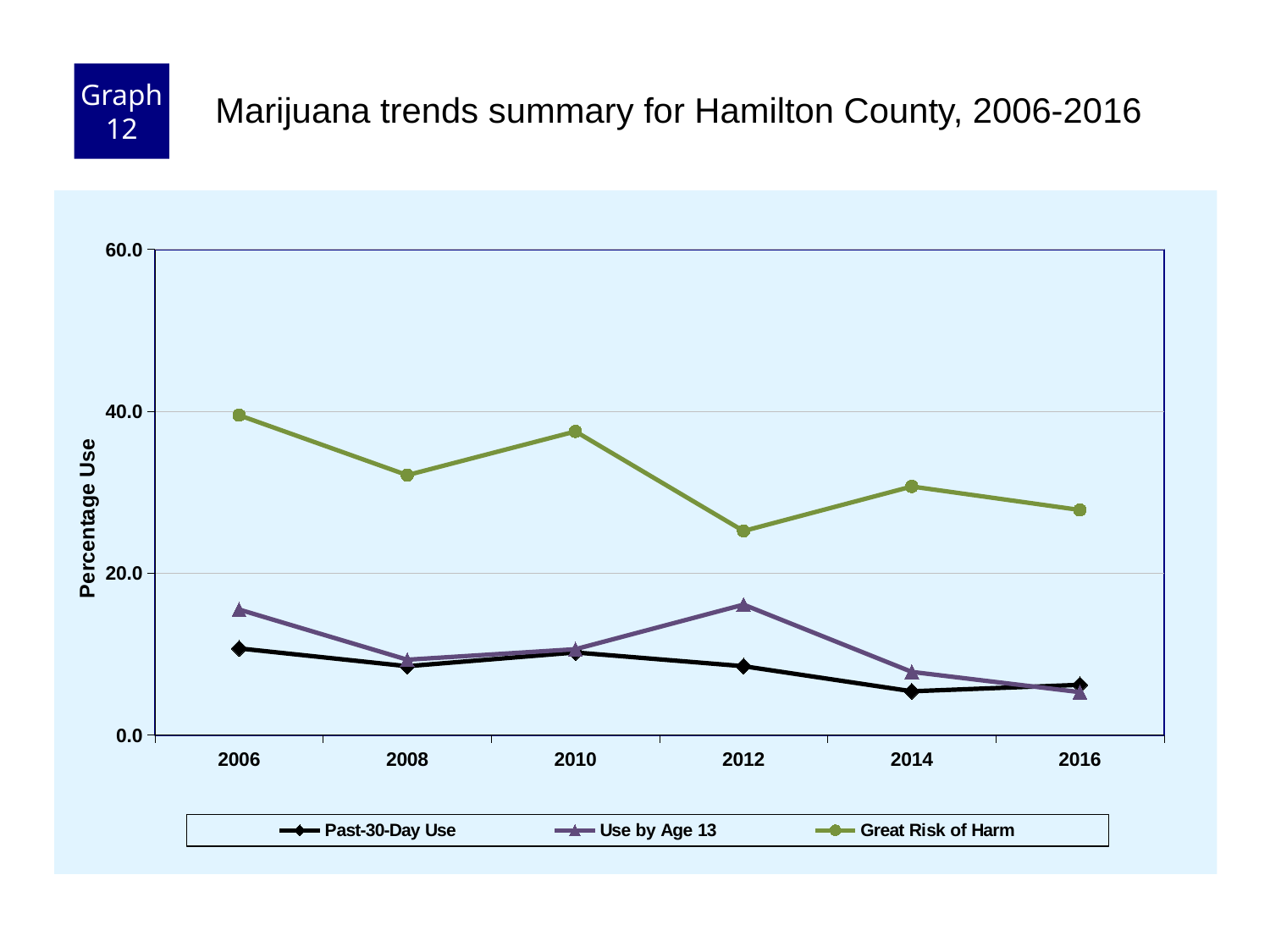
In which year is the Great Risk of Harm value lowest? 2012 Is the Great Risk of Harm value for 2012 greater or less than 20? greater Which series has the highest values across all years? Great Risk of Harm Is the Great Risk of Harm value for 2008 greater or less than 40? less In which year is the Great Risk of Harm value highest? 2006 What kind of chart is shown on the slide? Line chart How many series does the legend list? 3 How many years are plotted along the x axis? 6 In which year is the Use by Age 13 value lowest? 2016 Does the Great Risk of Harm series overall rise or fall from 2006 to 2016? Fall In 2012, which is larger: Use by Age 13 or Past-30-Day Use? Use by Age 13 Is the Use by Age 13 value for 2006 greater or less than 20? less